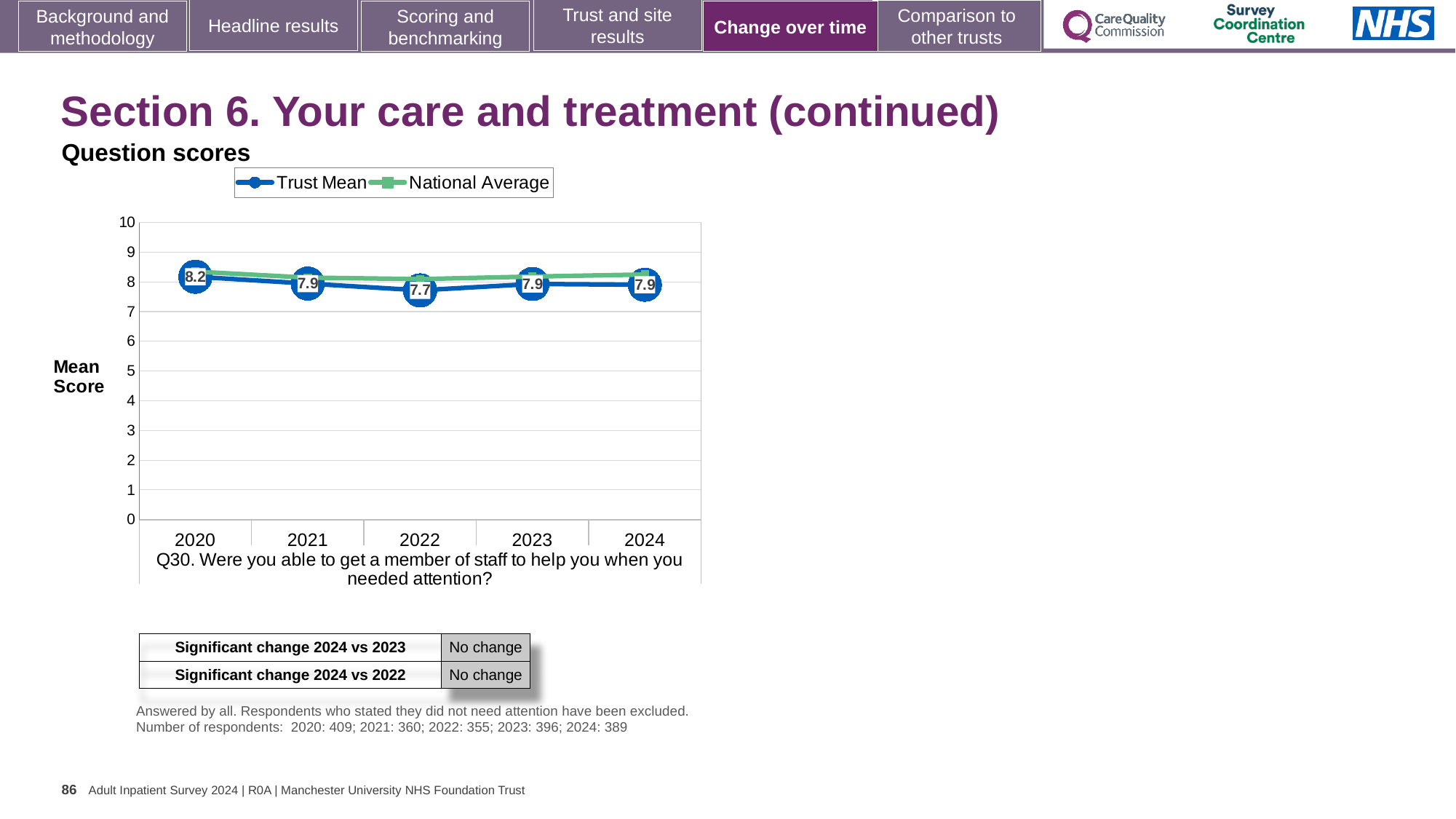
What kind of chart is shown? Line chart How many years are plotted on the x axis? 5 Which year has the larger Trust Mean, 2020 or 2022? 2020 Does the Trust Mean rise or fall from 2020 to 2022? Fall What is the Trust Mean score for 2024? 7.9 What is the difference between the Trust Mean in 2020 and in 2022? 0.5 What is the Trust Mean score for 2020? 8.2 How many series does the legend list? 2 In which year is the Trust Mean lowest? 2022 What is the Trust Mean score for 2022? 7.7 Is the National Average value for 2020 greater or less than 5? greater In which year is the Trust Mean highest? 2020